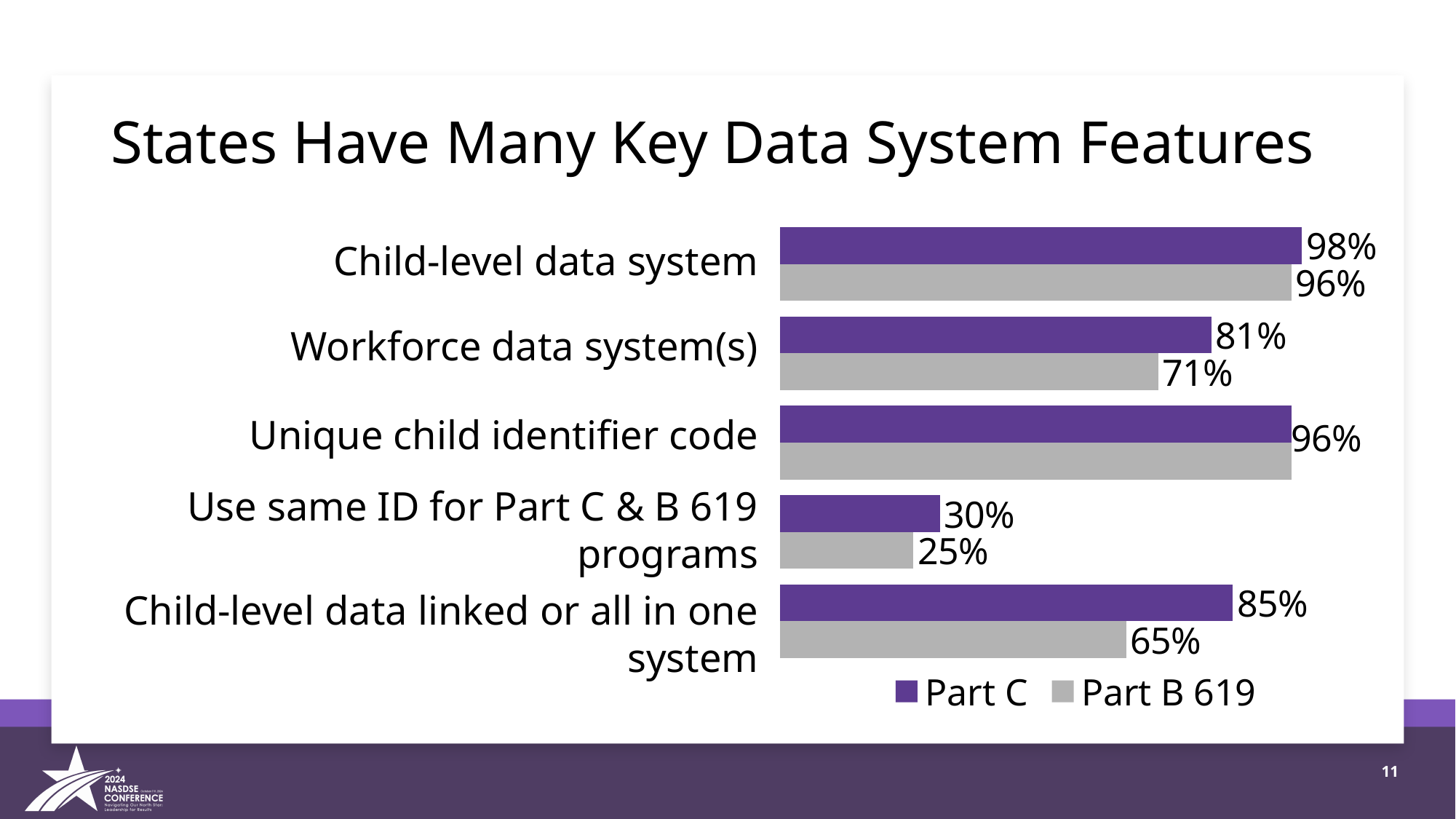
What is the Part B 619 value for Child-level data linked or all in one system? 65% What is the Part C value for Child-level data system? 98% Which category has the highest Part C value? Child-level data system What kind of chart is shown on the slide? bar chart What is the difference between the Part C and Part B 619 values for Child-level data linked or all in one system? 20% Which is larger for Workforce data system(s): the Part C value or the Part B 619 value? Part C Which category has the lowest Part B 619 value? Use same ID for Part C & B 619 programs Which series is shown in purple? Part C What is the Part B 619 value for Workforce data system(s)? 71% How many categories are shown on the chart? 5 How many series does the legend list? 2 What is the Part C value for Use same ID for Part C & B 619 programs? 30%